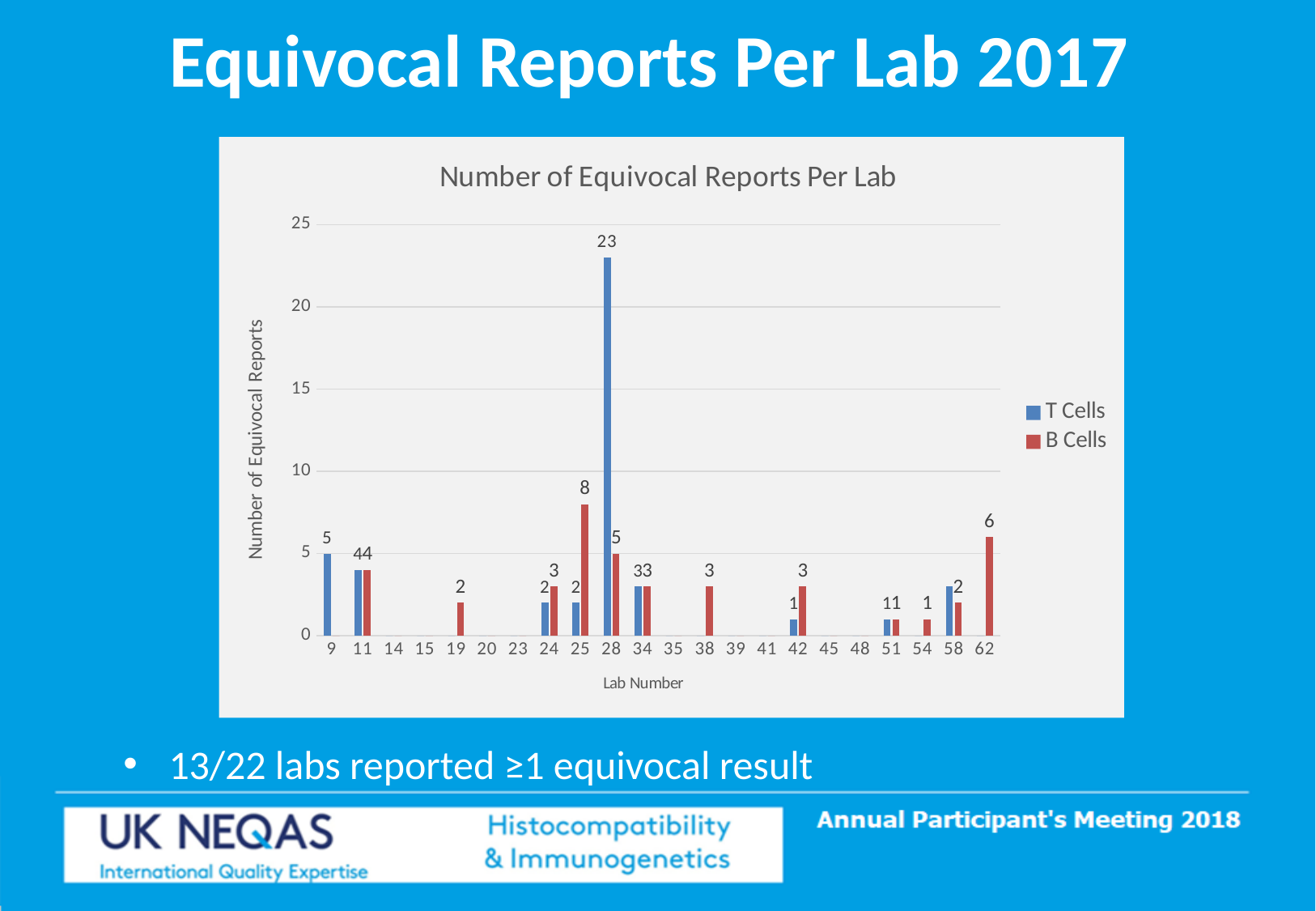
For lab 25, which is larger, the T Cells value or the B Cells value? B Cells How many lab numbers are shown on the x axis? 22 Which lab has the highest number of B Cells equivocal reports? 25 What is the title of the y axis? Number of Equivocal Reports Which lab has the highest number of T Cells equivocal reports? 28 What is the B Cells value for lab 25? 8 What is the T Cells value for lab 28? 23 For lab 28, what is the difference between the T Cells and B Cells values? 18 What is the T Cells value for lab 9? 5 What is the B Cells value for lab 62? 6 How many series does the legend list? 2 What kind of chart is shown on the slide? Bar chart